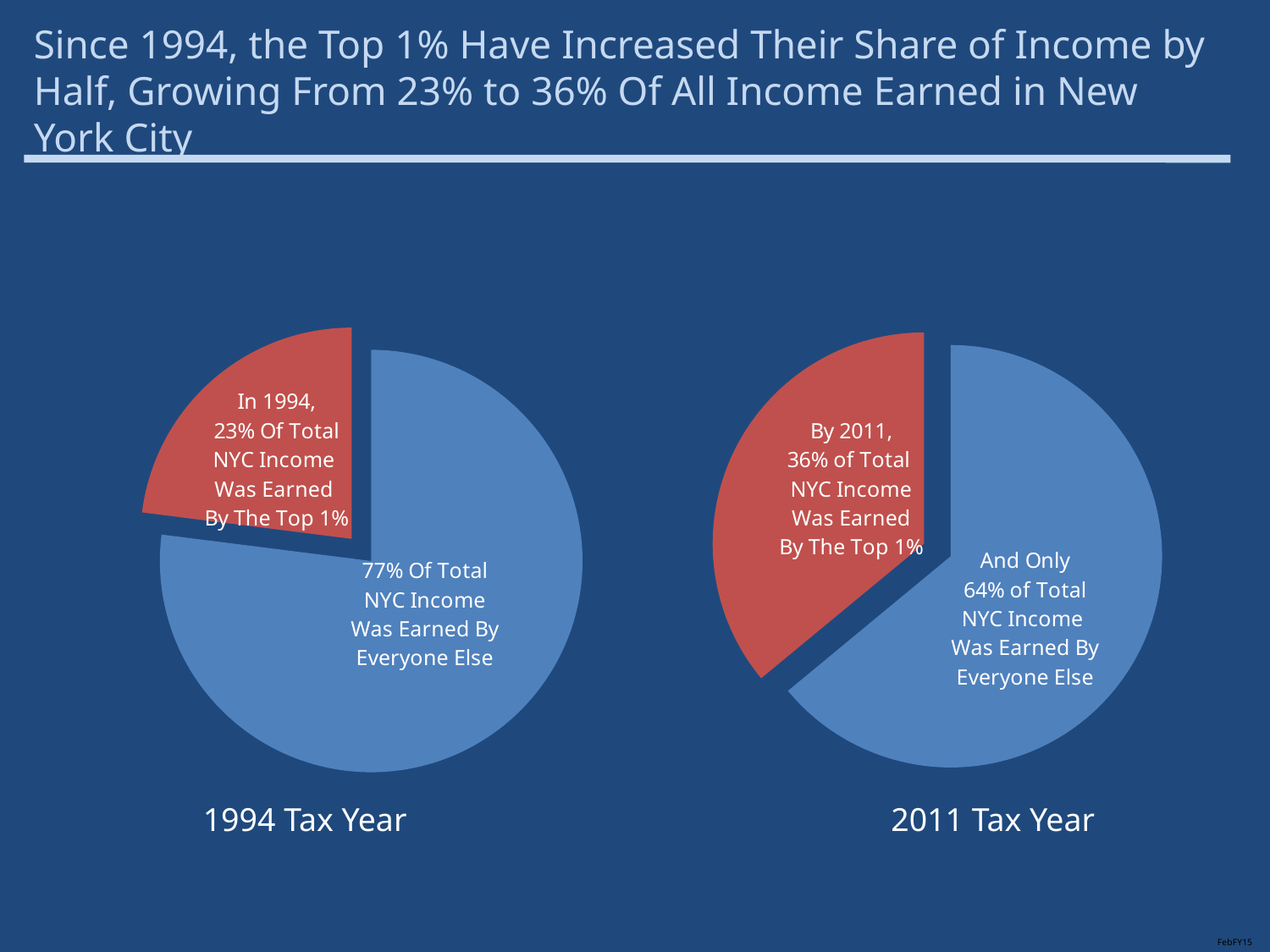
What kind of chart is the 1994 Tax Year chart? pie chart In the 1994 Tax Year chart, what is the difference between the everyone else share and the top 1% share? 54 percentage points What is the label beneath the right-hand pie chart? 2011 Tax Year In the 1994 Tax Year chart, which slice is the smallest? the top 1% How many slices does the 2011 Tax Year pie chart have? 2 In the 2011 Tax Year chart, what share of total NYC income was earned by the top 1%? 36% In the 2011 Tax Year chart, what share of total NYC income was earned by everyone else? 64% In the 1994 Tax Year chart, what share of total NYC income was earned by the top 1%? 23% What is the difference between the top 1% share in the 2011 Tax Year chart and the top 1% share in the 1994 Tax Year chart? 13 percentage points Which colour is used for the top 1% slice in both pie charts? red In the 1994 Tax Year chart, what share of total NYC income was earned by everyone else? 77% In the 2011 Tax Year chart, which slice is larger: the top 1% or everyone else? everyone else